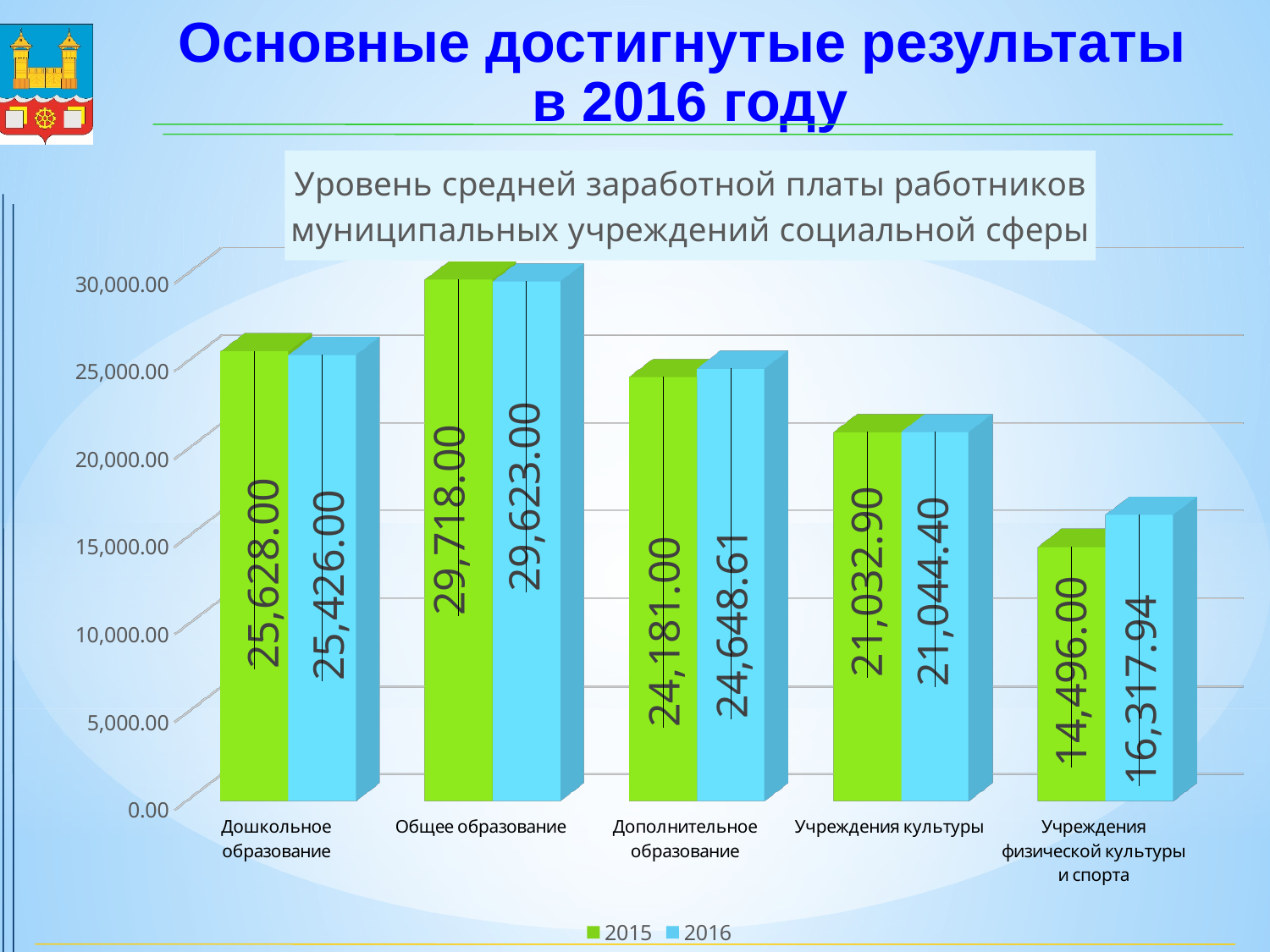
What kind of chart is shown on the slide? bar chart What is the difference between the 2015 and 2016 values for Дошкольное образование? 202.00 How many series does the legend list? 2 How many categories are shown on the x axis? 5 Which is larger for Учреждения культуры: the 2015 value or the 2016 value? 2016 What is the average salary for Общее образование in 2015? 29,718.00 What is the difference between the 2016 and 2015 values for Учреждения физической культуры и спорта? 1,821.94 Which category has the lowest average salary in 2015? Учреждения физической культуры и спорта Is the 2015 value for Учреждения физической культуры и спорта greater or less than 15,000.00? less Which category has the highest average salary in 2016? Общее образование What is the value for Дополнительное образование in 2016? 24,648.61 What is the average salary for Учреждения физической культуры и спорта in 2016? 16,317.94